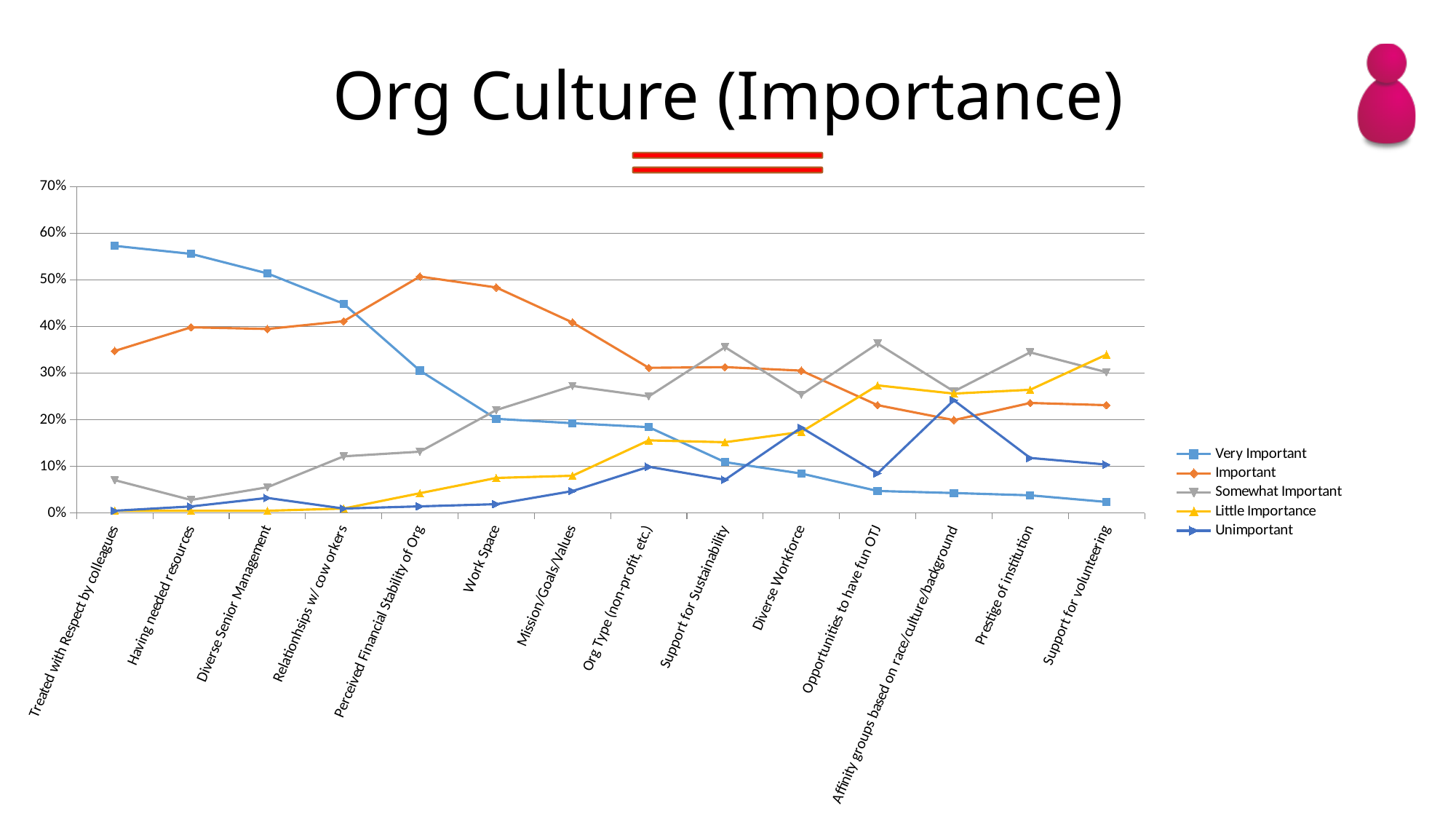
What kind of chart is shown on the slide? Line chart For which category is the Unimportant series highest? Affinity groups based on race/culture/background For which category is the Little Importance series highest? Support for volunteering How many series does the legend list? 5 At Work Space, which is larger: the Important value or the Very Important value? Important Is the Very Important value for Support for volunteering greater or less than 10%? less Is the Somewhat Important value for Opportunities to have fun OTJ greater or less than 30%? greater Is the Important value for Work Space greater or less than 40%? greater What is the title of the chart? Org Culture (Importance) How many categories are plotted along the x axis? 14 Does the Very Important series generally rise or fall from left to right along the x axis? Fall